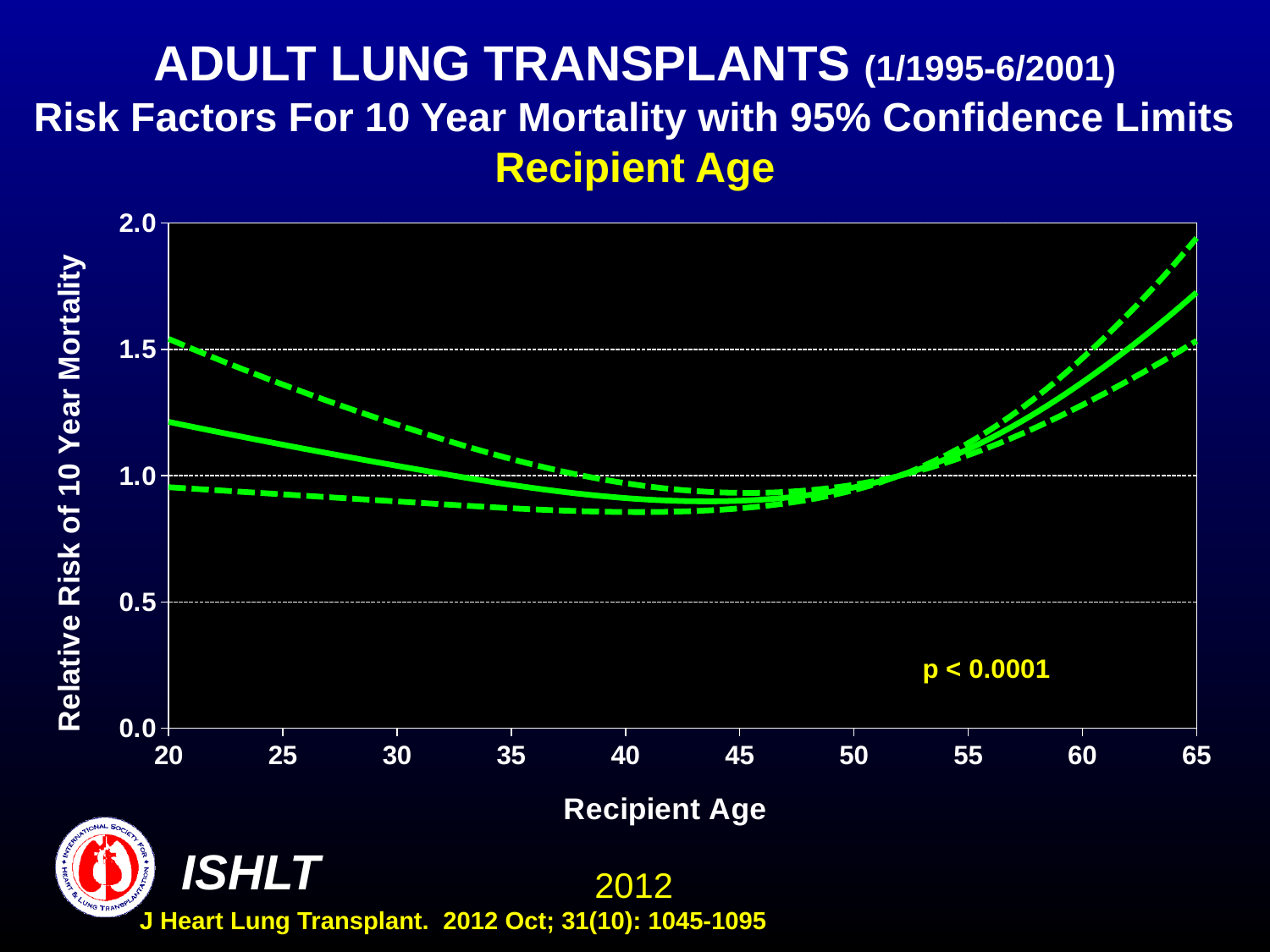
What is the label of the y axis? Relative Risk of 10 Year Mortality Does the solid line rise or fall as recipient age increases from 50 to 65? rise Is the value of the solid line at recipient age 40 greater or less than 1.0? less Is the value of the solid line at recipient age 20 greater or less than 1.0? greater Is the value of the solid line at recipient age 65 greater or less than 1.5? greater What is the label of the x axis? Recipient Age What p-value is printed on the chart? p < 0.0001 Does the solid line rise or fall as recipient age increases from 20 to 40? fall How many lines are plotted on the chart? 3 What kind of chart is shown on the slide? line chart Is the solid line higher at recipient age 65 or at recipient age 20? 65